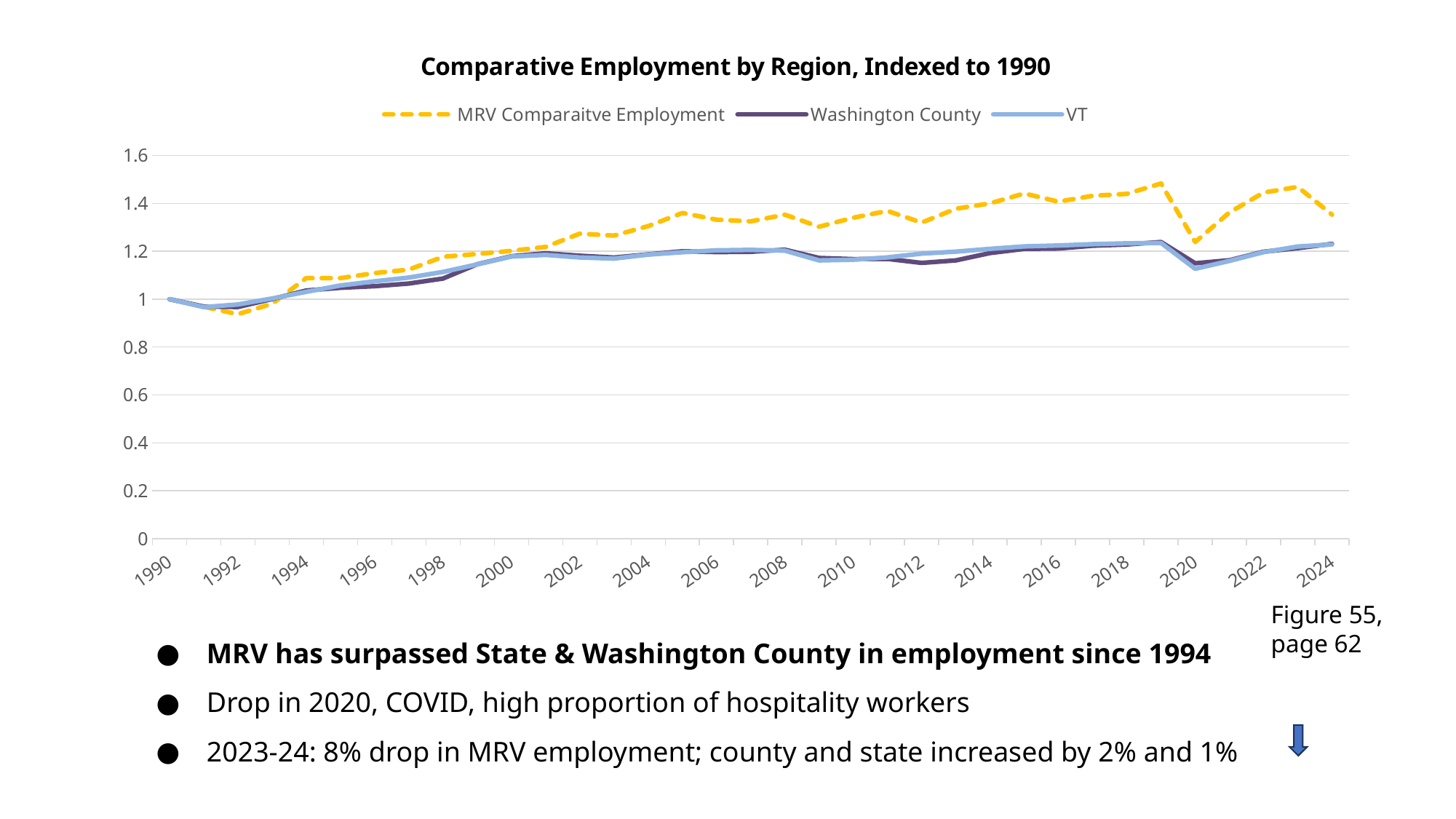
Is the value for MRV Comparaitve Employment in 2020 greater or less than 1.4? less In 2016, which is larger: the value for MRV Comparaitve Employment or the value for VT? MRV Comparaitve Employment Is the value for VT in 2020 greater or less than 1.2? less Which series is drawn with a dashed yellow line? MRV Comparaitve Employment Is the value for MRV Comparaitve Employment in 1992 greater or less than 1? less What is the title of the chart? Comparative Employment by Region, Indexed to 1990 Does the VT series generally rise or fall from 1990 to 2024? rise What kind of chart is shown on the slide? line chart Which series has the highest value in 2024? MRV Comparaitve Employment How many series does the legend list? 3